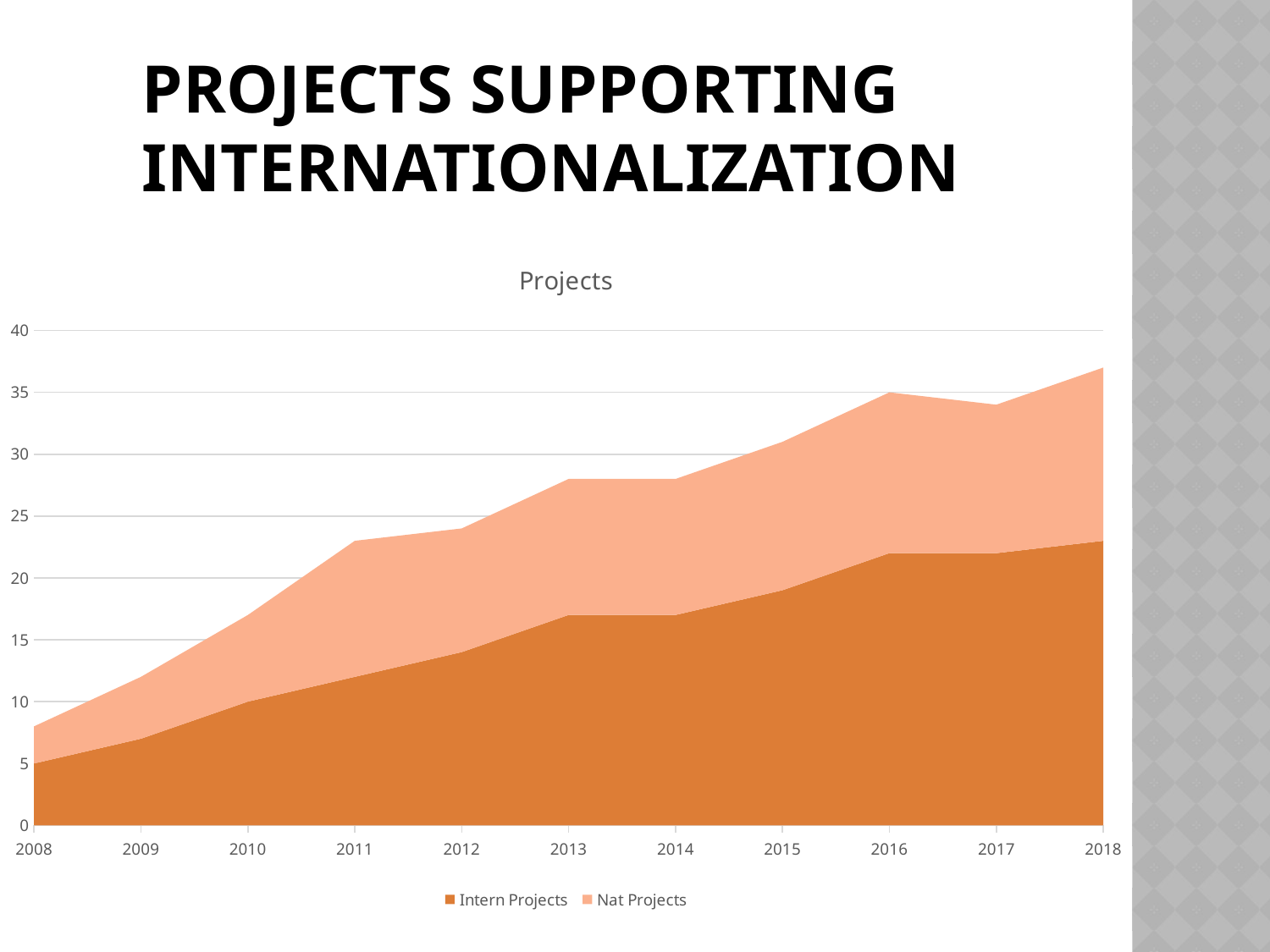
How many series does the legend list? 2 Is the combined total of Intern Projects and Nat Projects in 2018 greater or less than 35? greater Which series is shown in the darker orange colour at the bottom of the chart? Intern Projects What is the title of the chart? Projects What kind of chart is shown on the slide? Stacked area chart How many years are shown along the x axis? 11 What is the value for Intern Projects in 2008? 5 Is the combined total of Intern Projects and Nat Projects in 2008 greater or less than 10? less What is the value for Intern Projects in 2010? 10 Is the value for Intern Projects in 2018 greater or less than 20? greater Do the Intern Projects values generally rise or fall from 2008 to 2018? Rise